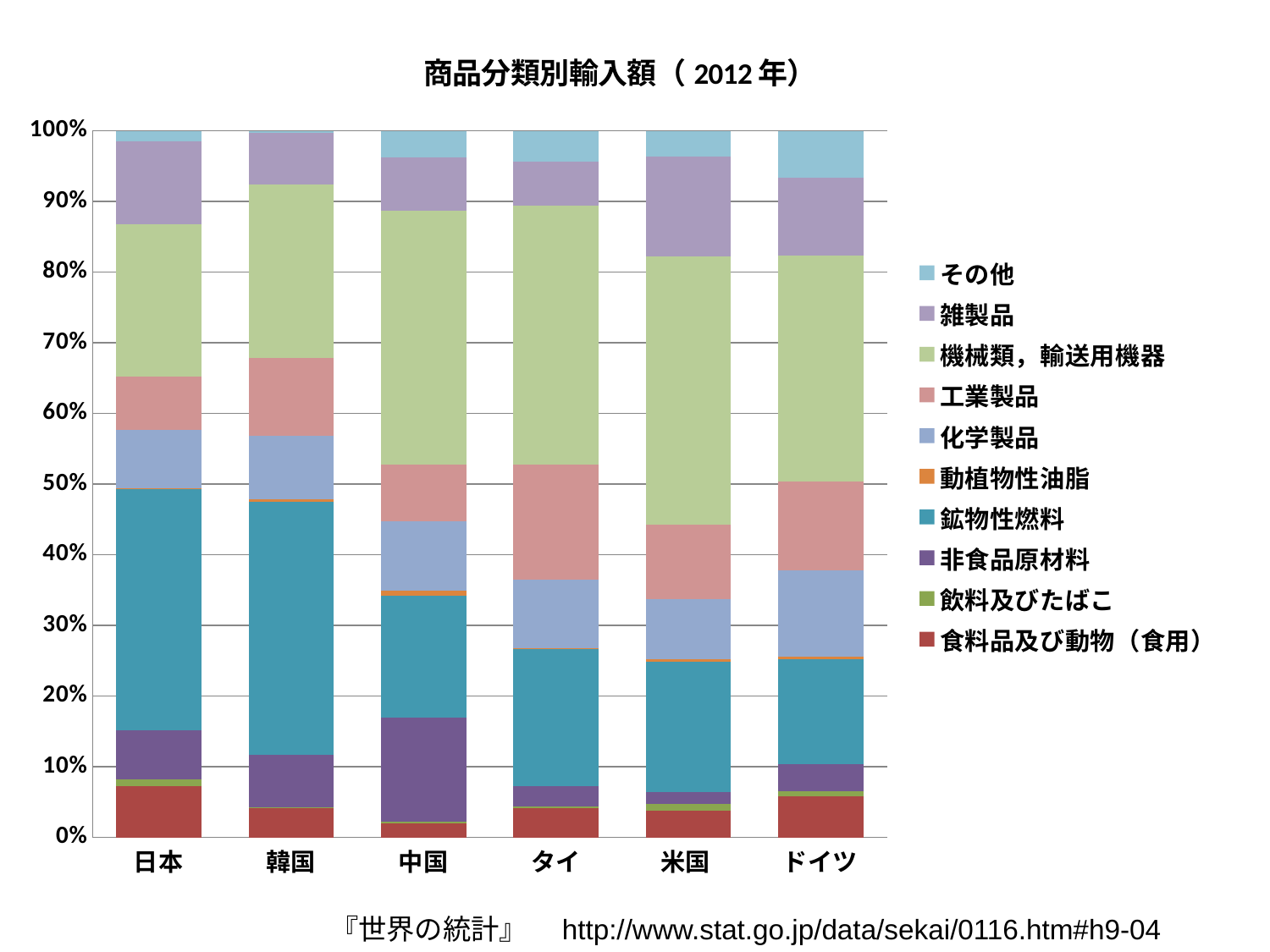
How many series does the chart's legend list? 10 How many countries are shown on the x axis of the chart? 6 Which legend entry is listed first (at the top) in the chart's legend? その他 What is the title of the chart? 商品分類別輸入額（2012年） Is the 食料品及び動物（食用） share for ドイツ greater or less than 10%? less Is the 鉱物性燃料 share for 日本 greater or less than 30%? greater Which country has the larger 鉱物性燃料 share, 日本 or ドイツ? 日本 Is the 機械類，輸送用機器 share for 米国 greater or less than 30%? greater What kind of chart is shown on the slide? stacked bar chart Which country has the largest 非食品原材料 share? 中国 Which country has the largest その他 share? ドイツ